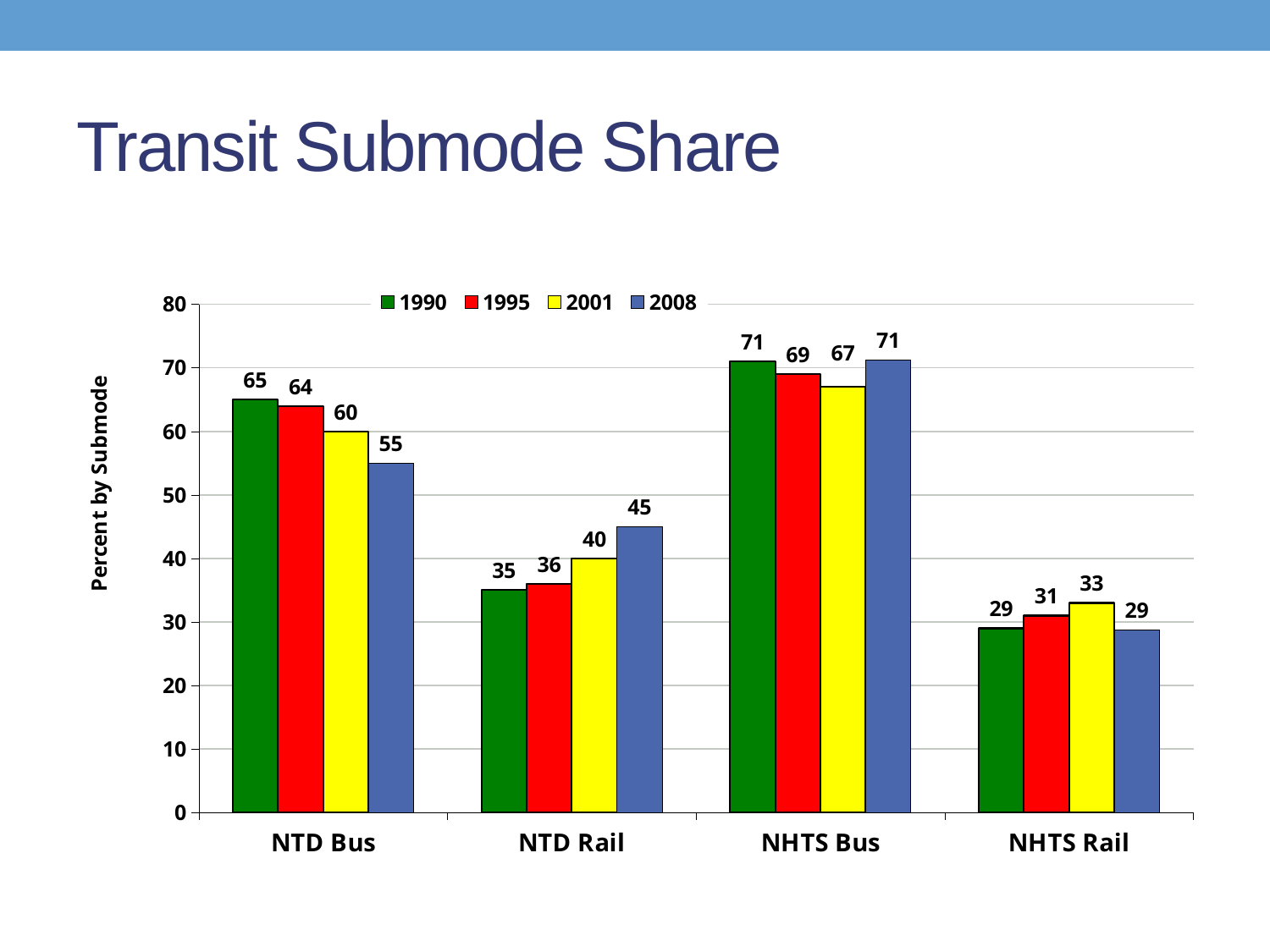
Which category has the lowest value for the 2008 series? NHTS Rail Is the value for NHTS Bus in 2001 greater or less than 60? greater What is the value for NTD Rail in 1990? 35 How many categories are shown on the x axis? 4 What is the value for NHTS Rail in 2001? 33 How many series does the legend list? 4 What is the value for NTD Bus in 2008? 55 What is the label of the vertical axis? Percent by Submode Which category has the highest value for the 1995 series? NHTS Bus What is the difference between the 1990 and 2008 values for NTD Bus? 10 Which is larger for NTD Rail: the 1995 value or the 2008 value? 2008 What kind of chart is shown on the slide? Bar chart